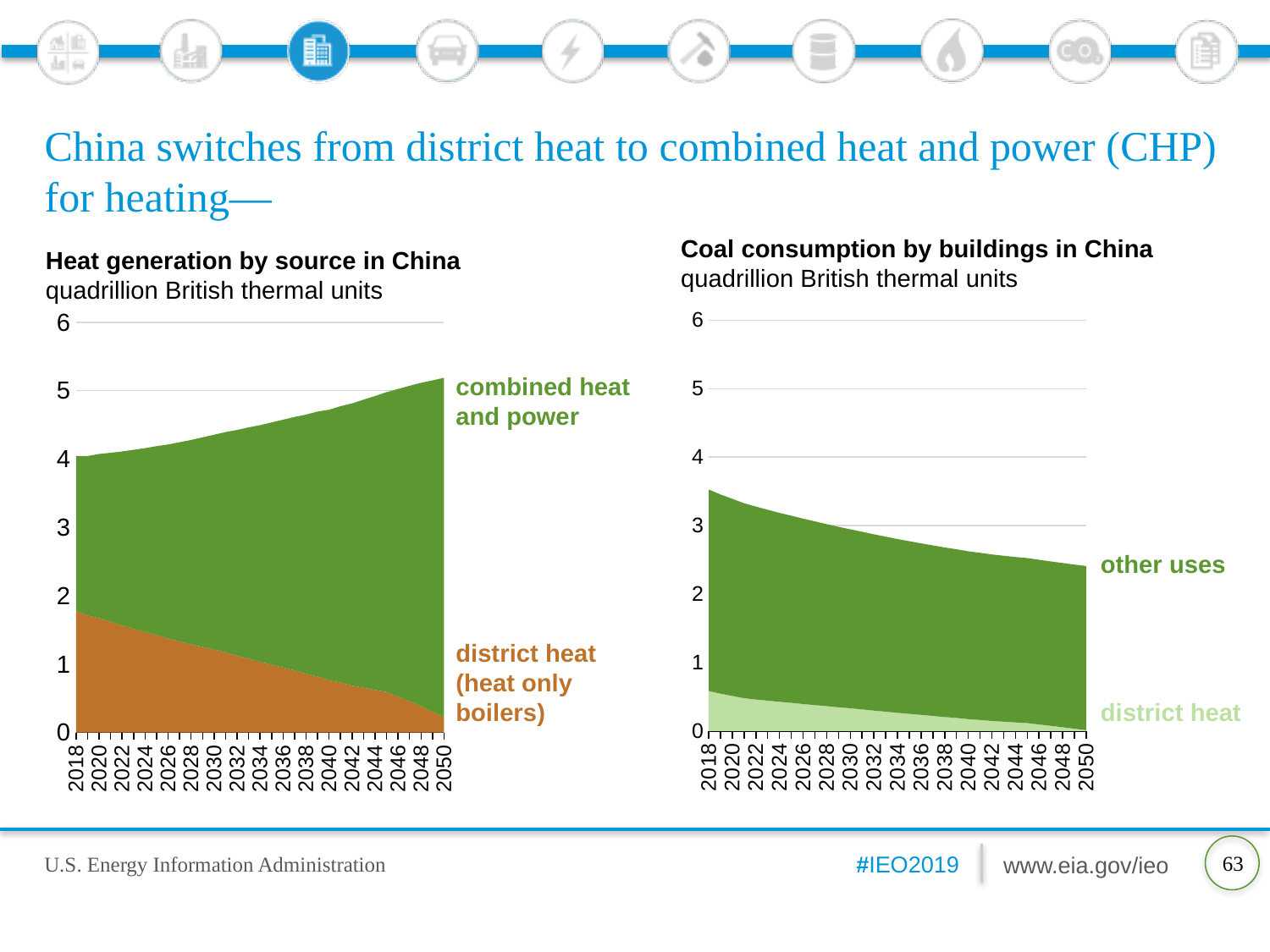
In the 'Coal consumption by buildings in China' chart, which is larger in 2018: other uses or district heat? other uses In the 'Heat generation by source in China' chart, does the district heat (heat only boilers) area rise or fall from 2018 to 2050? fall How many series are shown in the 'Coal consumption by buildings in China' chart? 2 In the 'Heat generation by source in China' chart, is the value for district heat (heat only boilers) in 2018 greater or less than 1? greater In the 'Heat generation by source in China' chart, does total heat generation rise or fall from 2018 to 2050? rise What kind of chart is the 'Heat generation by source in China' chart? stacked area chart What unit is used on the y axis of both charts? quadrillion British thermal units In the 'Heat generation by source in China' chart, which is larger in 2050: combined heat and power or district heat (heat only boilers)? combined heat and power How many series are shown in the 'Heat generation by source in China' chart? 2 In the 'Coal consumption by buildings in China' chart, is total coal consumption in 2050 greater or less than 3? less In the 'Heat generation by source in China' chart, is the value for district heat (heat only boilers) in 2050 greater or less than 1? less In the 'Coal consumption by buildings in China' chart, does total coal consumption rise or fall from 2018 to 2050? fall